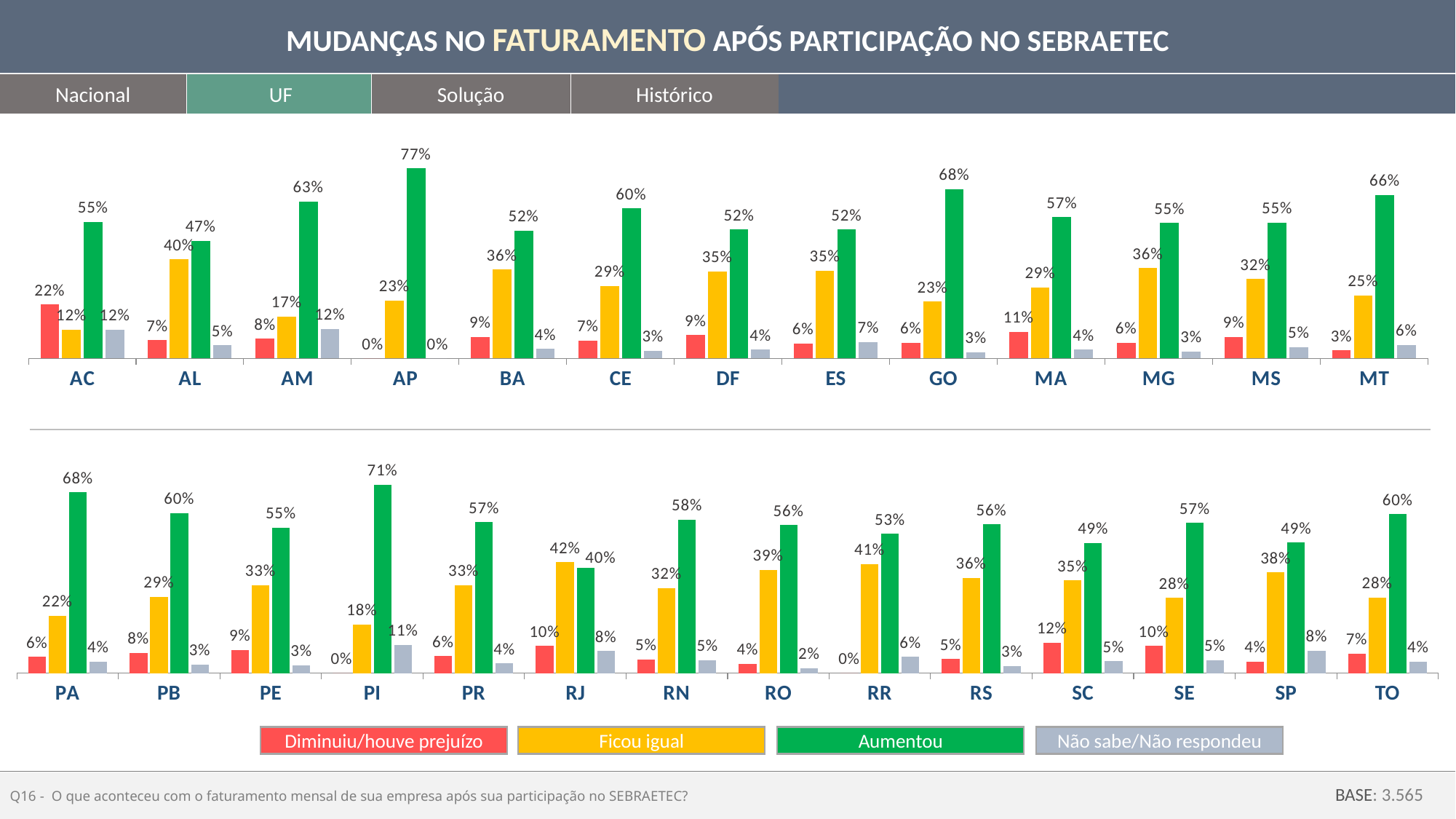
In the top chart, what is the value of 'Aumentou' for AP? 77% In the bottom chart, which state has the lowest 'Aumentou' value? RJ In the top chart, what is the value of 'Diminuiu/houve prejuízo' for AC? 22% In the bottom chart, what is the value of 'Ficou igual' for RJ? 42% How many states are shown in the bottom chart? 14 What type of chart is used on this slide? Bar chart How many states are shown in the top chart? 13 In the top chart, which state has the highest 'Aumentou' value? AP How many series does the legend list? 4 In the top chart, what is the difference between the 'Aumentou' values for GO and AC? 13% Which colour represents 'Aumentou' in the legend? Green In the bottom chart, which is larger: 'Ficou igual' for RJ or 'Aumentou' for RJ? Ficou igual